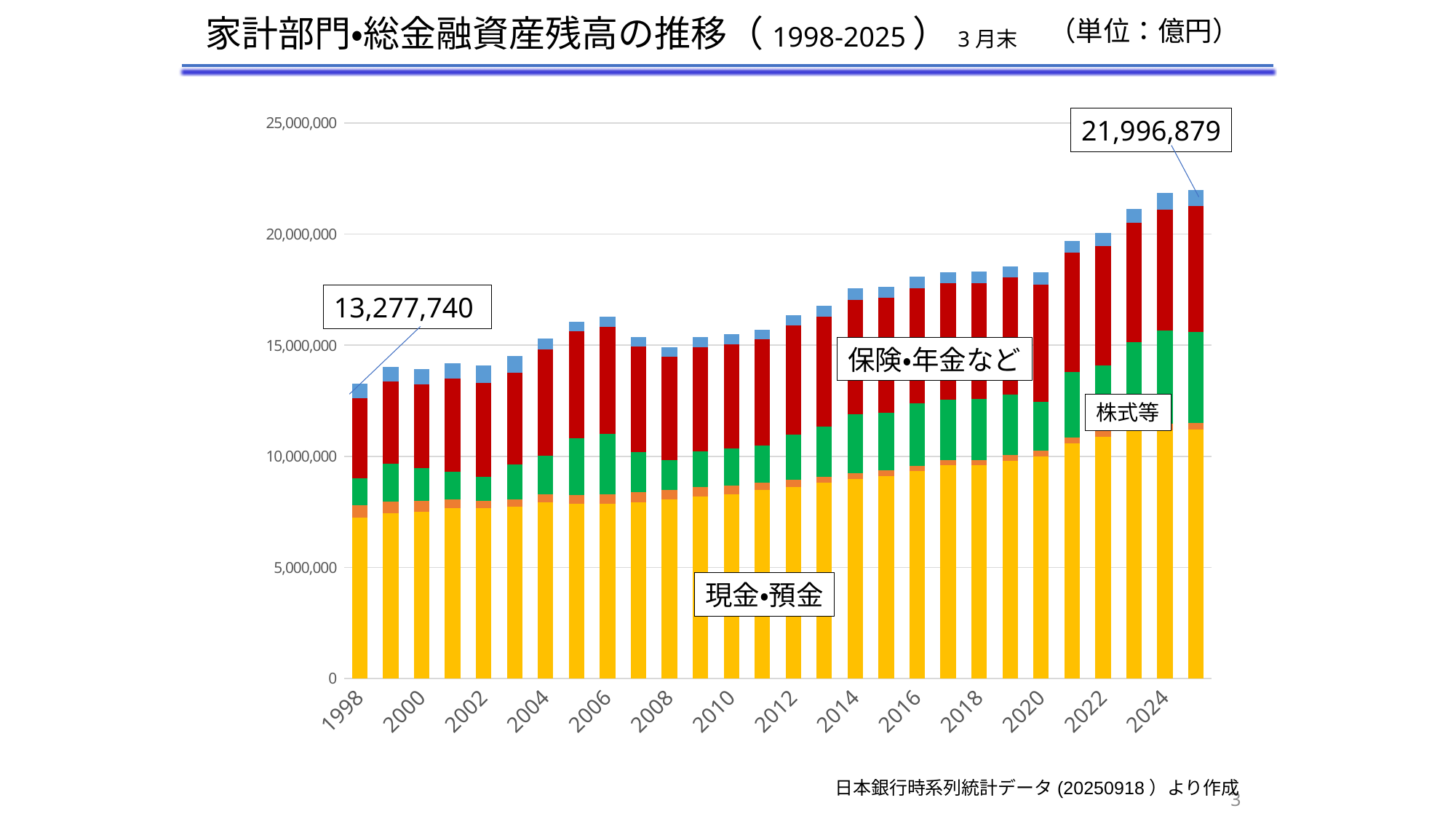
What is the total household financial asset balance shown for 2025? 21,996,879 Does the total balance generally rise or fall from 1998 to 2025? Rise What is the total household financial asset balance shown for 1998? 13,277,740 Which asset category forms the bottom (yellow) segment of each bar? 現金・預金 Which year has the highest total balance? 2025 What unit are the values on the chart expressed in? 億円 Is the total balance for 2025 greater or less than 20,000,000? greater By how much did the total balance increase from 1998 to 2025, according to the labelled values? 8,719,139 Which year has the lowest total balance? 1998 How many years (bars) are plotted in the chart? 28 What kind of chart is shown on the slide? Stacked bar chart Is the 現金・預金 segment for 2010 greater or less than 10,000,000? less